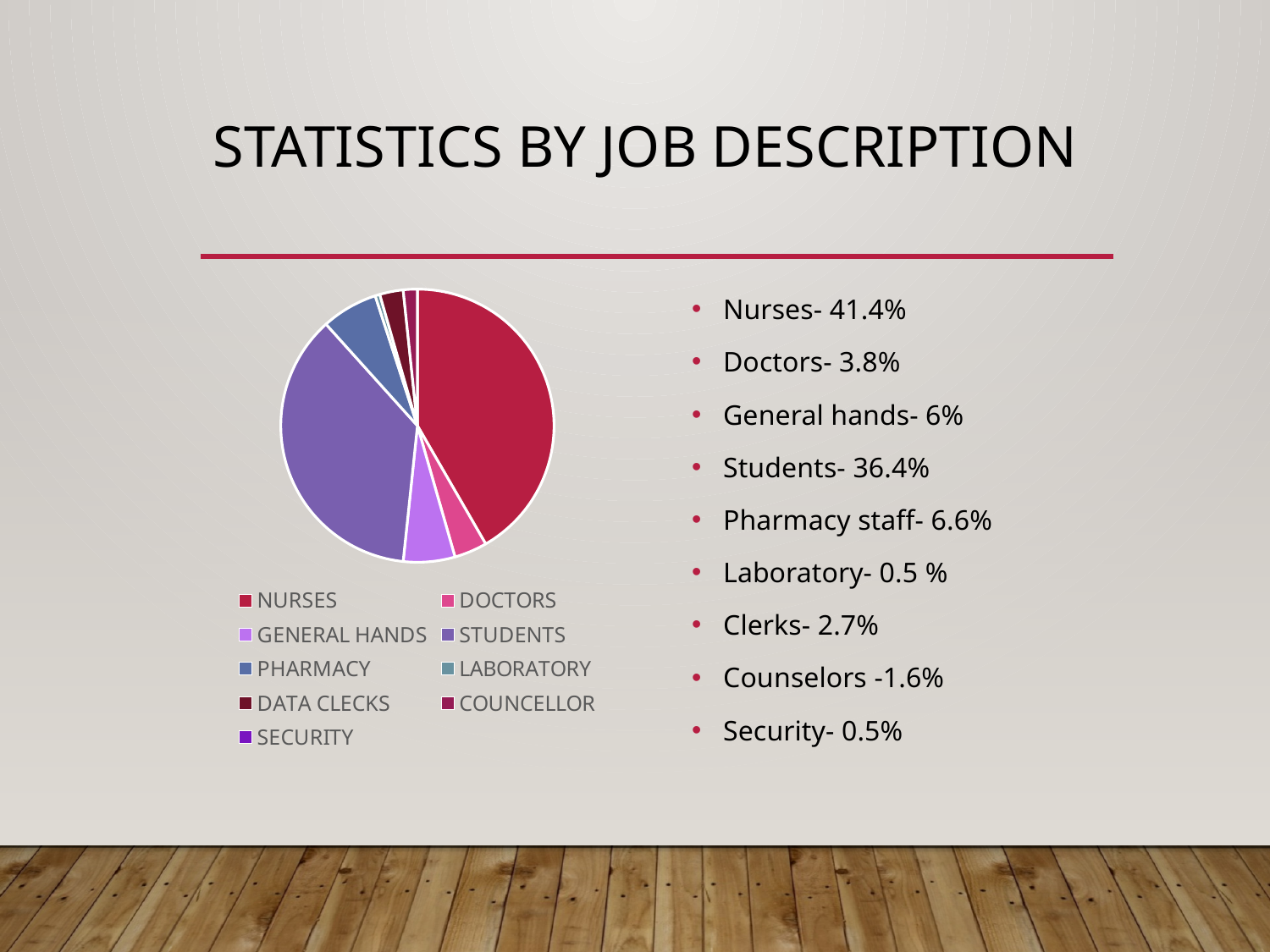
What share of the pie do Nurses account for? 41.4% What is the value for Doctors? 3.8% What is the value for Students? 36.4% What is the value for Clerks? 2.7% Which category has the largest slice of the pie chart? Nurses What is the value for Pharmacy staff? 6.6% What is the difference between the Nurses and Students percentages? 5% What is the difference between the Pharmacy staff and Doctors percentages? 2.8% Which slice is larger, Nurses or Students? Nurses What kind of chart is shown on the slide? pie chart What is the title of the slide containing the pie chart? STATISTICS BY JOB DESCRIPTION How many categories does the pie chart's legend list? 9